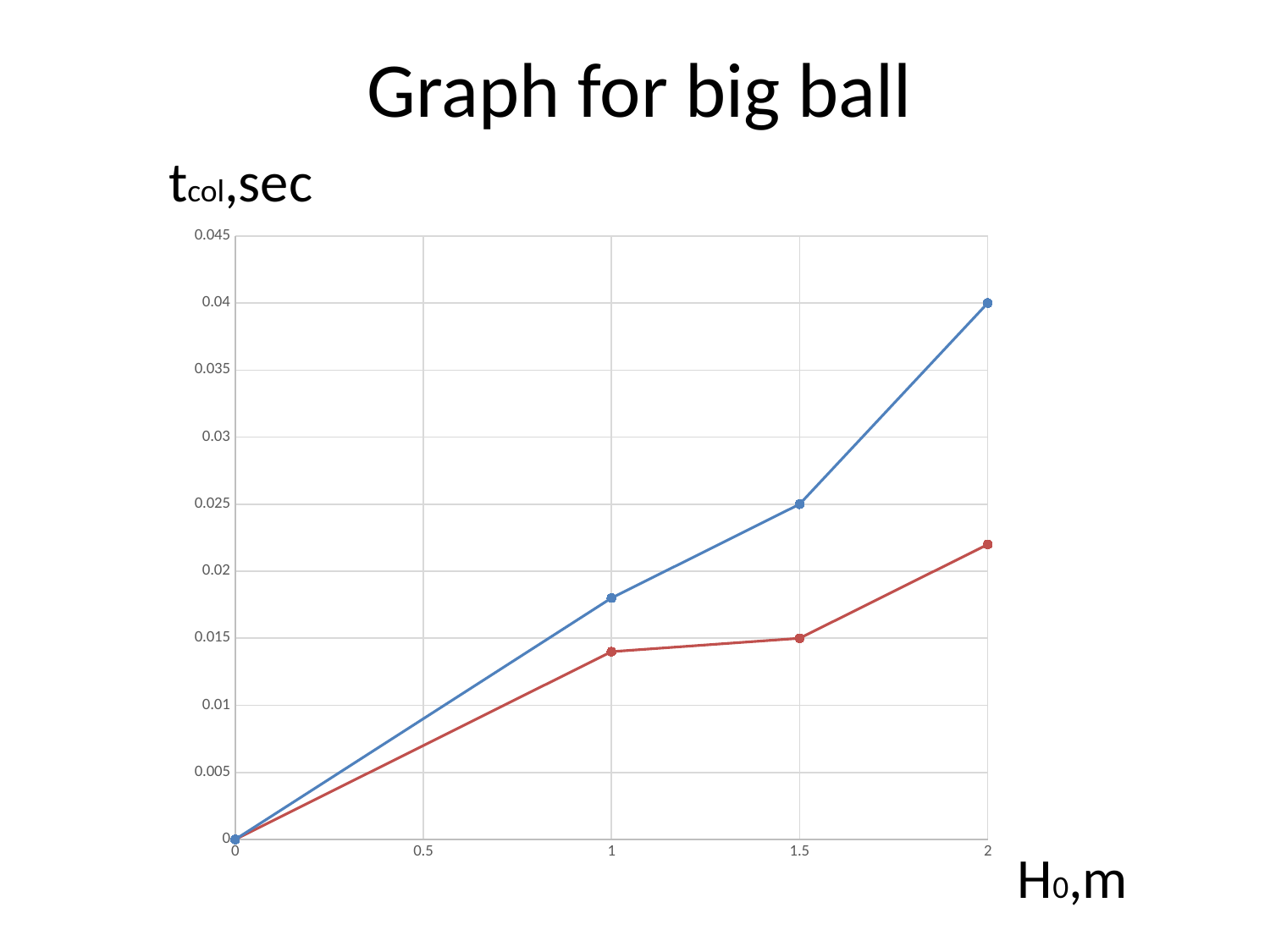
What is the value of the blue line at H0 = 1.5 m? 0.025 Do the values of the blue line rise or fall as H0 increases? rise Is the value of the red line at H0 = 2 m greater or less than 0.02? greater Is the value of the blue line at H0 = 1 m greater or less than 0.02? less What is the value of both lines at H0 = 0 m? 0 What is the title of the chart? Graph for big ball What kind of chart is shown on the slide? line chart What is the value of the blue line at H0 = 2 m? 0.04 What is the value of the red line at H0 = 1.5 m? 0.015 How many data points does the blue line have? 4 What is the label on the horizontal axis of the chart? H0,m At H0 = 2 m, which line has the higher value, the blue line or the red line? blue line